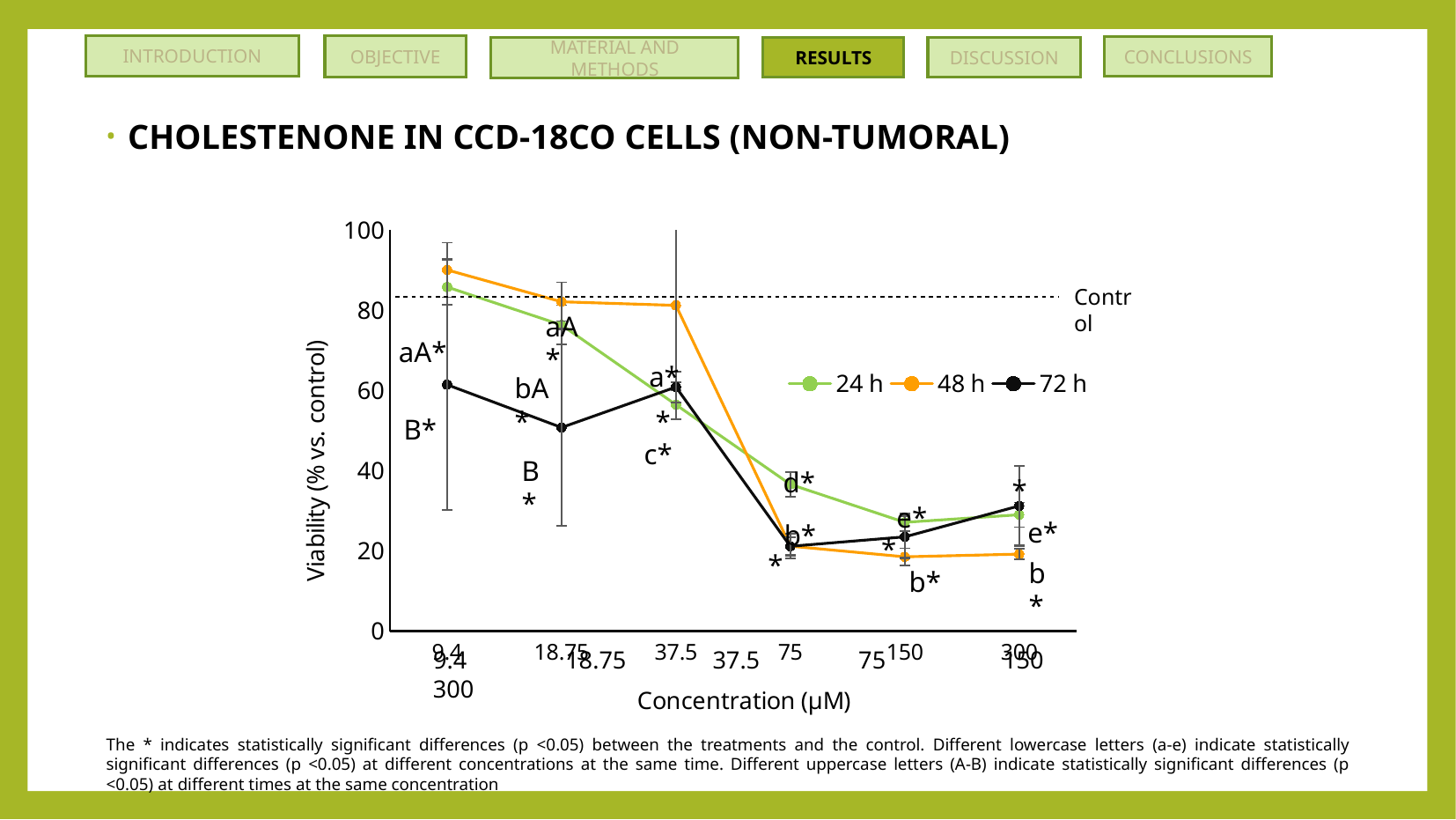
At 150 µM, which series has the lowest viability? 48 h How many series does the legend list? 3 What is the label of the y axis? Viability (% vs. control) Which series are listed in the legend? 24 h, 48 h, 72 h Is the value for 72 h at 9.4 µM greater or less than 80? less What kind of chart is shown on the slide? line chart How many concentration points are plotted for each series? 6 At 75 µM, which is larger: the value for 24 h or the value for 48 h? 24 h Is the value for 72 h at 18.75 µM greater or less than 60? less Is the value for 24 h at 75 µM greater or less than 40? less At 37.5 µM, which series has the highest viability? 48 h